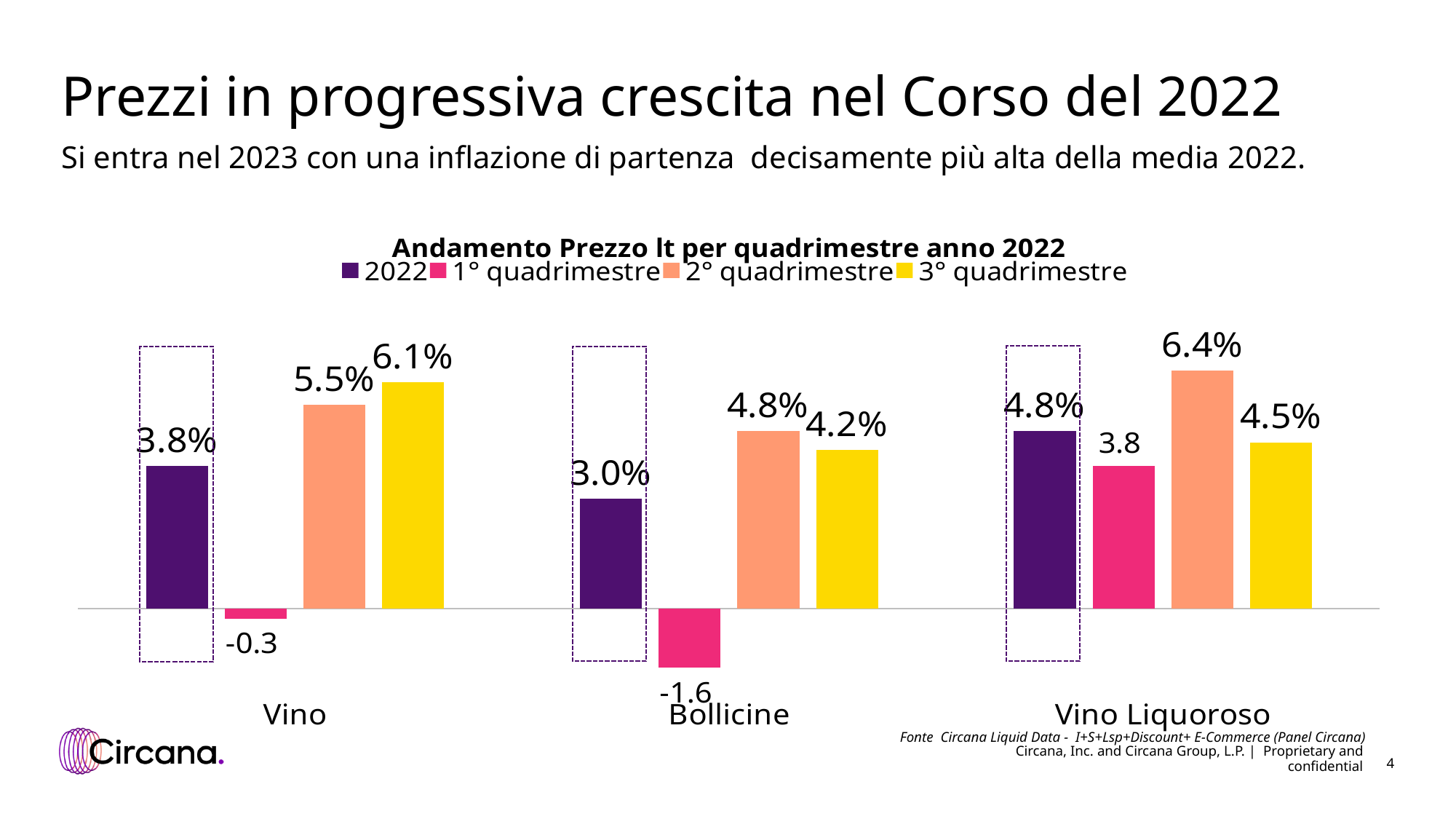
Which category has the lowest value in the 1° quadrimestre series? Bollicine For Vino Liquoroso, which is larger: the 2° quadrimestre value or the 3° quadrimestre value? 2° quadrimestre What is the difference between the 3° quadrimestre and 2022 values for Vino? 2.3% How many categories are shown on the x axis? 3 What is the value for the 2° quadrimestre series for Vino Liquoroso? 6.4% What is the value for the 3° quadrimestre series for Bollicine? 4.2% What is the value for the 2022 series for Vino? 3.8% What kind of chart is shown on the slide? Bar chart What is the value for the 1° quadrimestre series for Bollicine? -1.6 What is the title of the chart? Andamento Prezzo lt per quadrimestre anno 2022 Which category has the highest value in the 3° quadrimestre series? Vino How many series does the legend list? 4